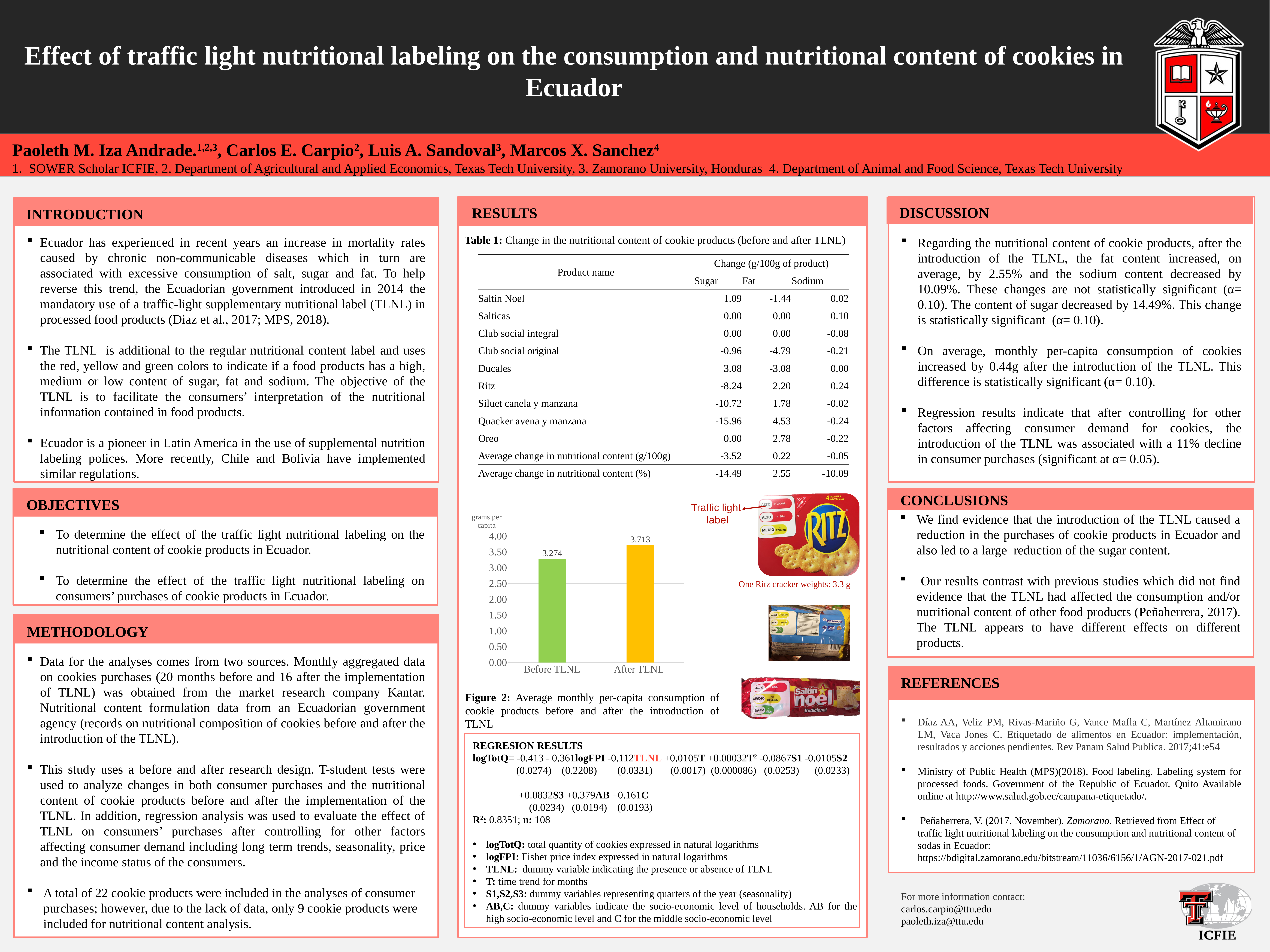
Which category has the lowest value in the bar chart? Before TLNL Is the value for After TLNL greater or less than 3.50? greater What is the value for Before TLNL in the bar chart? 3.274 What is the value for After TLNL in the bar chart? 3.713 What colour is the After TLNL bar in the chart? yellow What kind of chart is shown in Figure 2? bar chart Which category has the higher value in the bar chart, Before TLNL or After TLNL? After TLNL Do the values rise or fall from Before TLNL to After TLNL? rise Is the value for Before TLNL greater or less than 3.50? less What is the difference between the After TLNL and Before TLNL values in the bar chart? 0.439 What unit is shown on the y axis of the bar chart? grams per capita How many bars are shown in the chart? 2